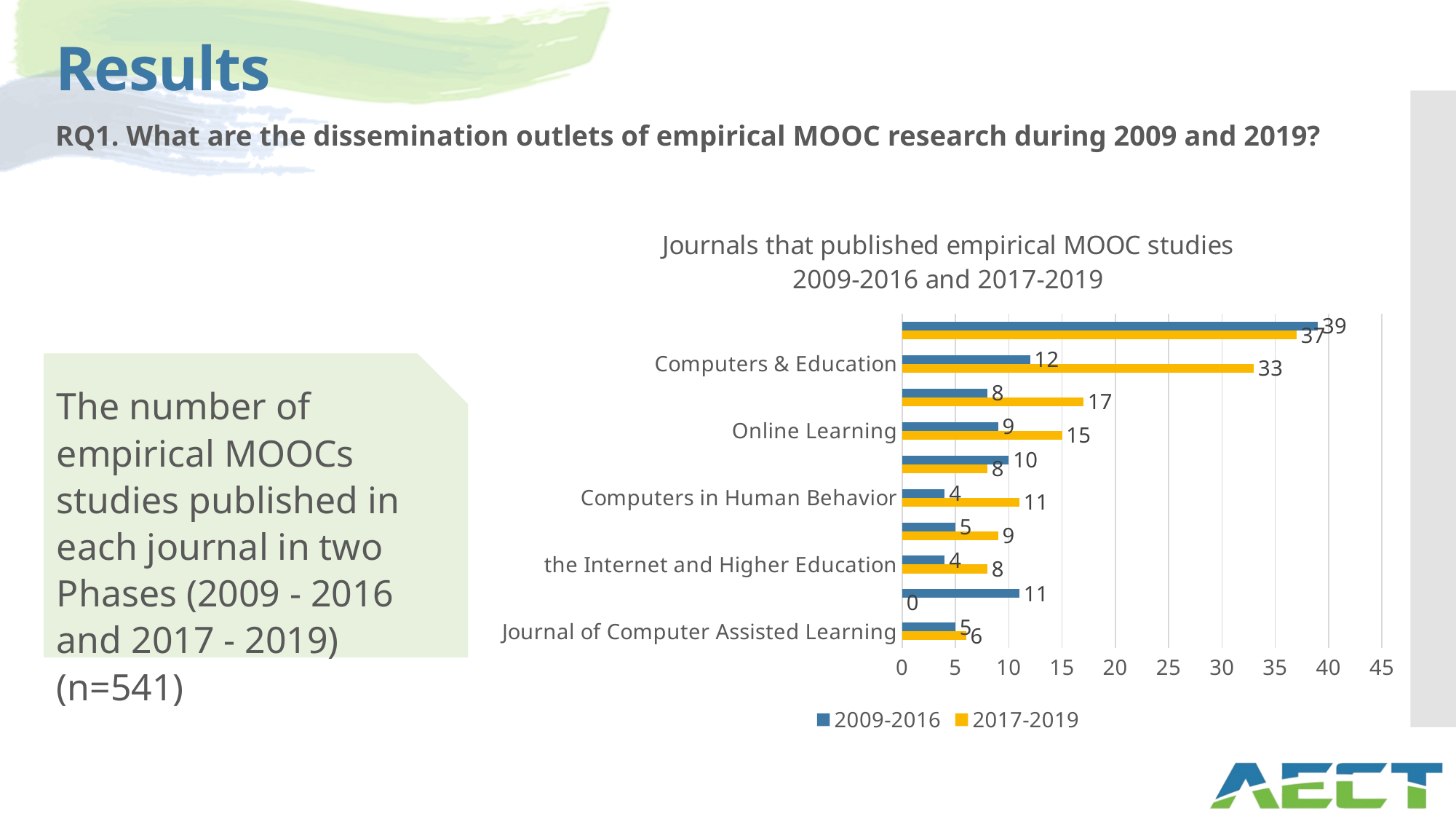
What kind of chart is shown on the slide? Bar chart What is the title of the chart? Journals that published empirical MOOC studies 2009-2016 and 2017-2019 Is the 2017-2019 value for Computers & Education greater or less than 30? greater Which is larger for Online Learning: the 2009-2016 value or the 2017-2019 value? 2017-2019 What is the 2017-2019 value for Online Learning? 15 What is the 2009-2016 value for Journal of Computer Assisted Learning? 5 What is the 2017-2019 value for Computers & Education? 33 How many series does the legend list? 2 What is the 2009-2016 value for Computers & Education? 12 What is the 2017-2019 value for the Internet and Higher Education? 8 What is the difference between the 2017-2019 and 2009-2016 values for Computers & Education? 21 What is the 2009-2016 value for Computers in Human Behavior? 4